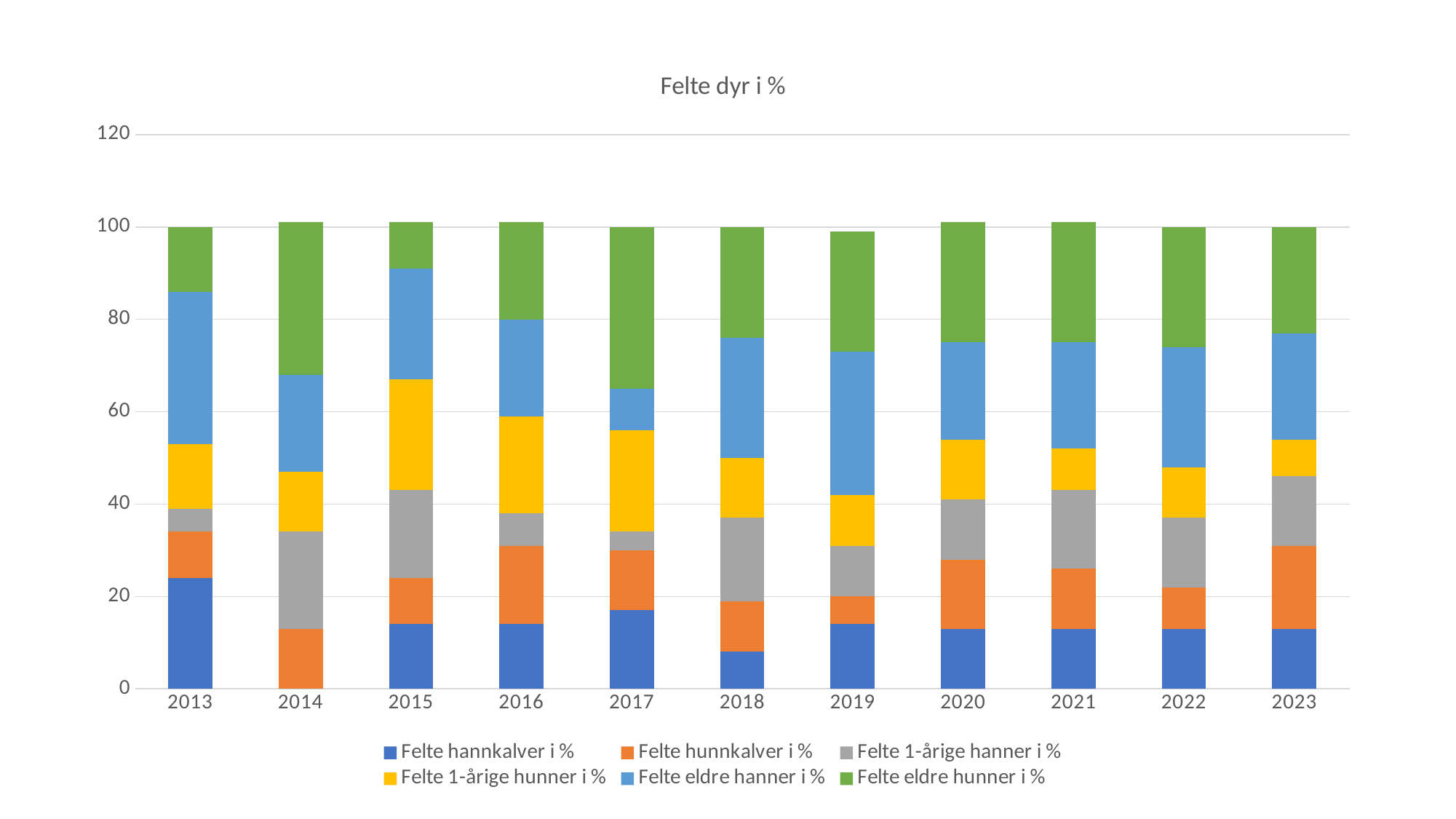
What kind of chart is shown on the slide? Stacked bar chart How many series does the legend list? 6 Which is larger, the Felte hannkalver i % segment in 2013 or in 2018? 2013 In which year is the Felte eldre hunner i % segment smallest? 2015 In which year is the Felte hannkalver i % segment lowest? 2014 Which is larger, the Felte eldre hunner i % segment in 2015 or in 2017? 2017 Which colour represents Felte eldre hunner i % in the legend? Green Is the value for Felte hannkalver i % in 2013 greater or less than 20? greater In which year is the Felte hannkalver i % segment highest? 2013 How many years are shown on the x axis? 11 Is the value for Felte hannkalver i % in 2018 greater or less than 20? less What is the title of the chart? Felte dyr i %